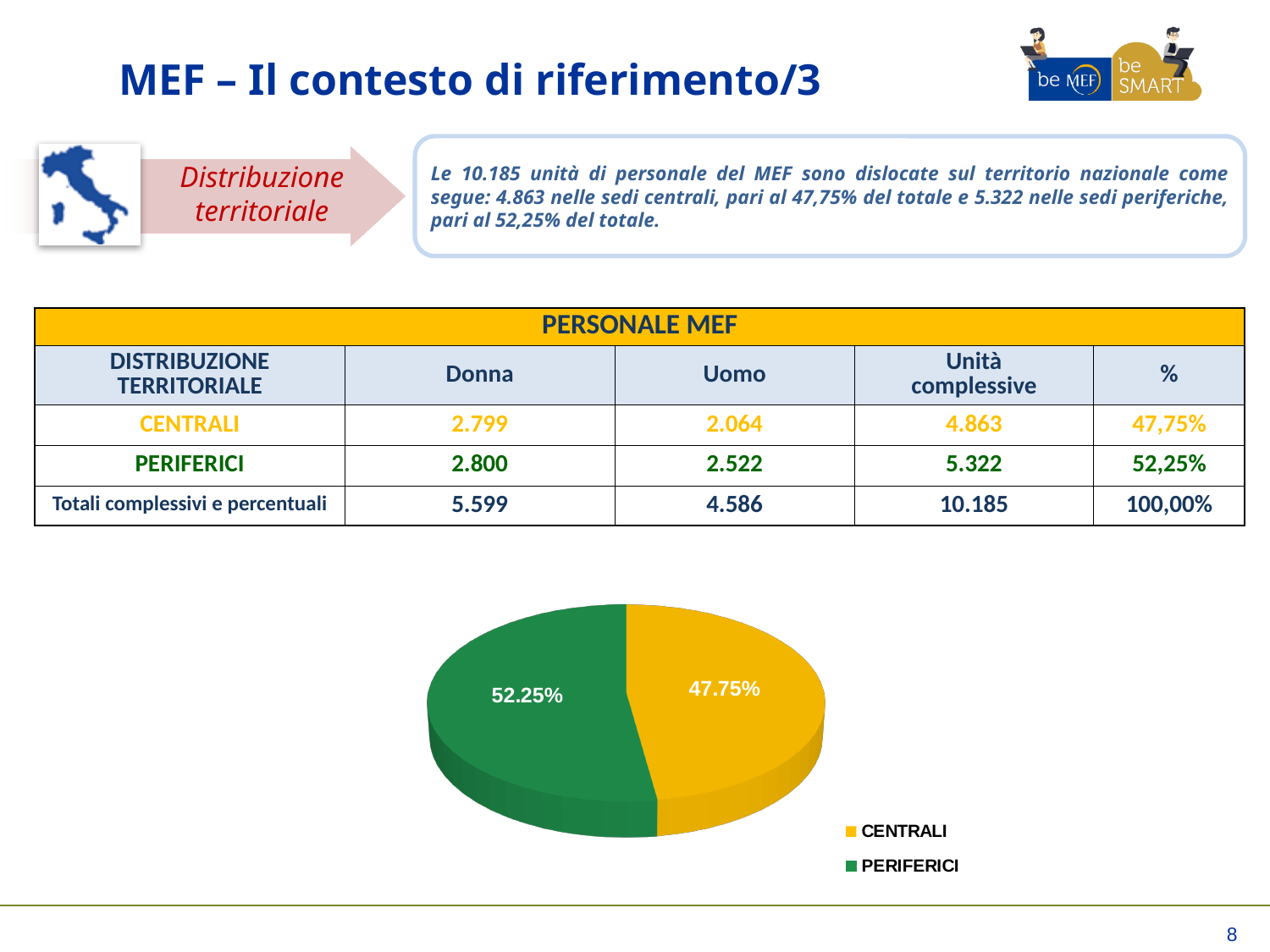
In the pie chart, which is larger, CENTRALI or PERIFERICI? PERIFERICI What share of the pie chart is labelled for PERIFERICI? 52.25% What colour is the CENTRALI slice in the pie chart? yellow Is the share for CENTRALI in the pie chart greater or less than 50%? less Which slice of the pie chart is the smallest? CENTRALI What kind of chart is shown on the slide? pie chart What colour is the PERIFERICI slice in the pie chart? green How many entries does the pie chart's legend list? 2 What is the difference in percentage points between the PERIFERICI and CENTRALI slices of the pie chart? 4.5 What share of the pie chart is labelled for CENTRALI? 47.75% How many slices does the pie chart have? 2 Which slice of the pie chart is the largest? PERIFERICI